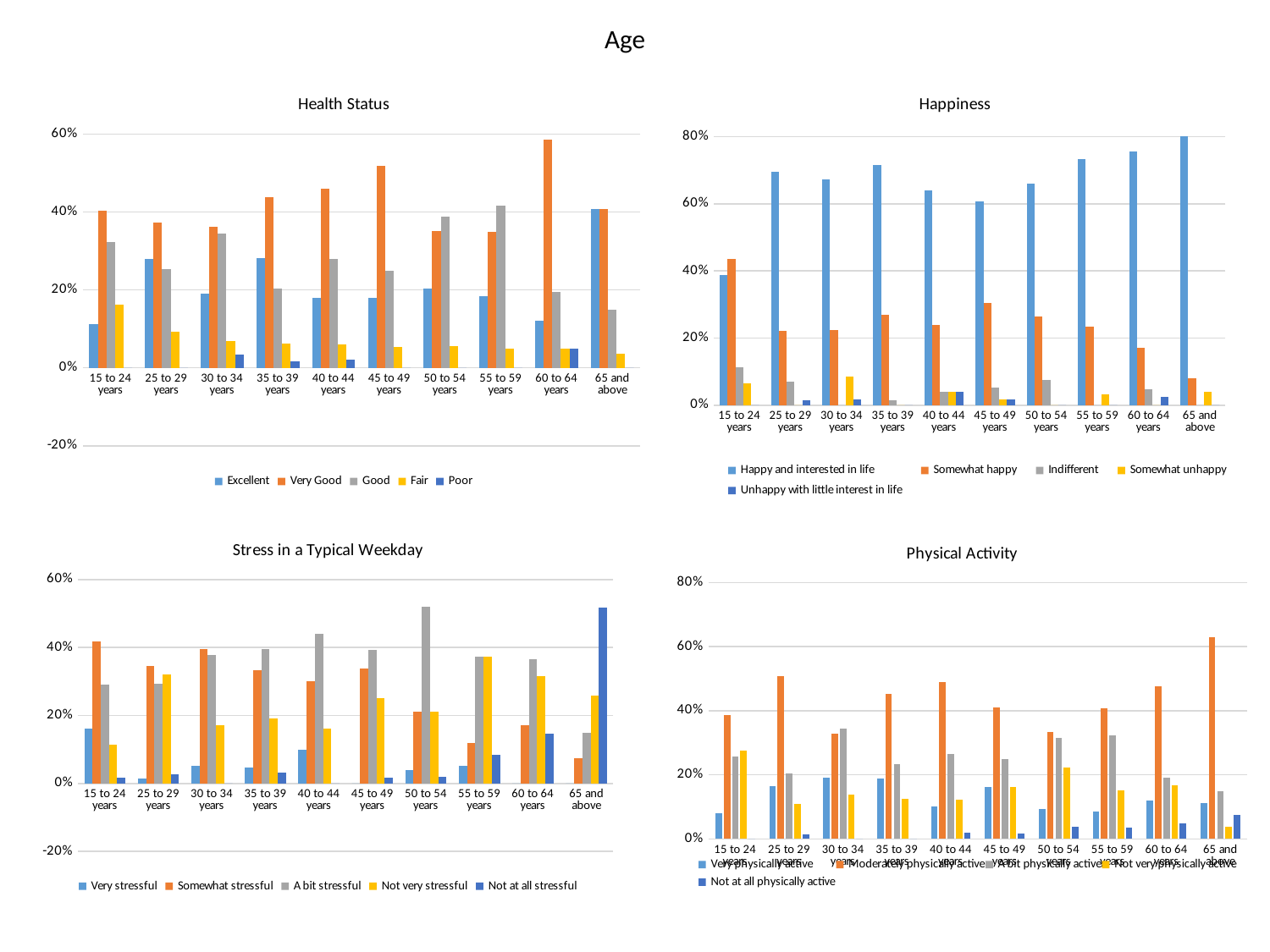
On the Happiness chart, how many series does the legend list? 5 On the Health Status chart, which age group has the highest value for Very Good? 60 to 64 years What kind of chart is the Physical Activity chart? bar chart On the Happiness chart, which age group has the lowest value for Happy and interested in life? 15 to 24 years How many charts are shown on the slide? 4 On the Health Status chart, how many age groups are shown on the x axis? 10 On the Stress in a Typical Weekday chart, is the value for Very stressful in the 15 to 24 years group greater or less than 20%? less On the Health Status chart, is the value for Very Good in the 60 to 64 years group greater or less than 40%? greater On the Physical Activity chart, which age group has the highest value for Moderately physically active? 65 and above On the Happiness chart, is the value for Happy and interested in life in the 25 to 29 years group greater or less than 60%? greater On the Stress in a Typical Weekday chart, which age group has the highest value for Not at all stressful? 65 and above